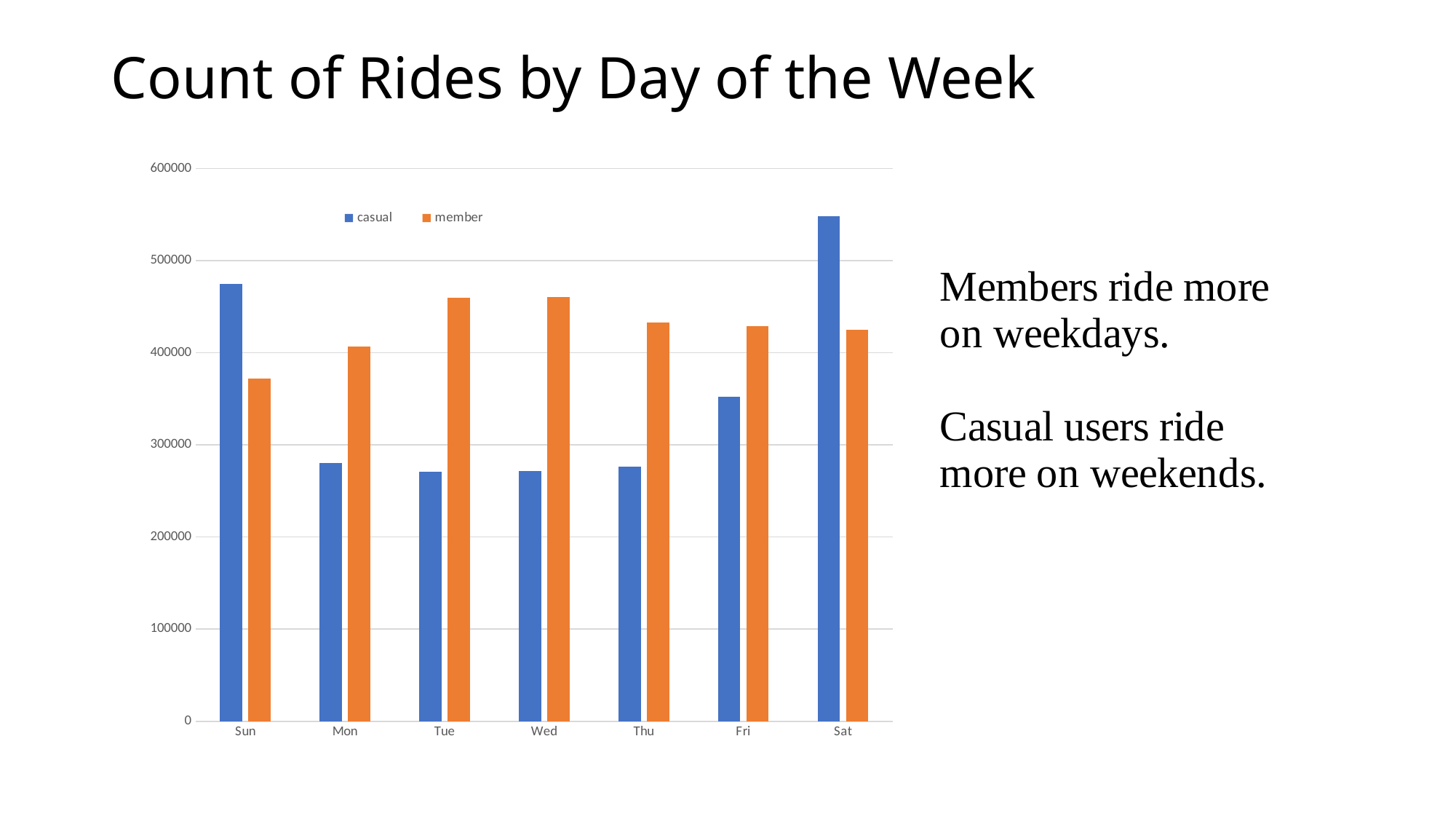
On which day is the member ride count lowest? Sun How many series does the legend list? 2 On which day is the casual ride count highest? Sat What kind of chart is shown on the slide? bar chart How many days of the week are shown on the x axis? 7 Is the casual value for Mon greater or less than 300000? less Is the casual value for Sat greater or less than 500000? greater On Mon, which is larger: the casual count or the member count? member Is the member value for Tue greater or less than 400000? greater What colour are the bars for the member series? orange On Sun, which is larger: the casual count or the member count? casual